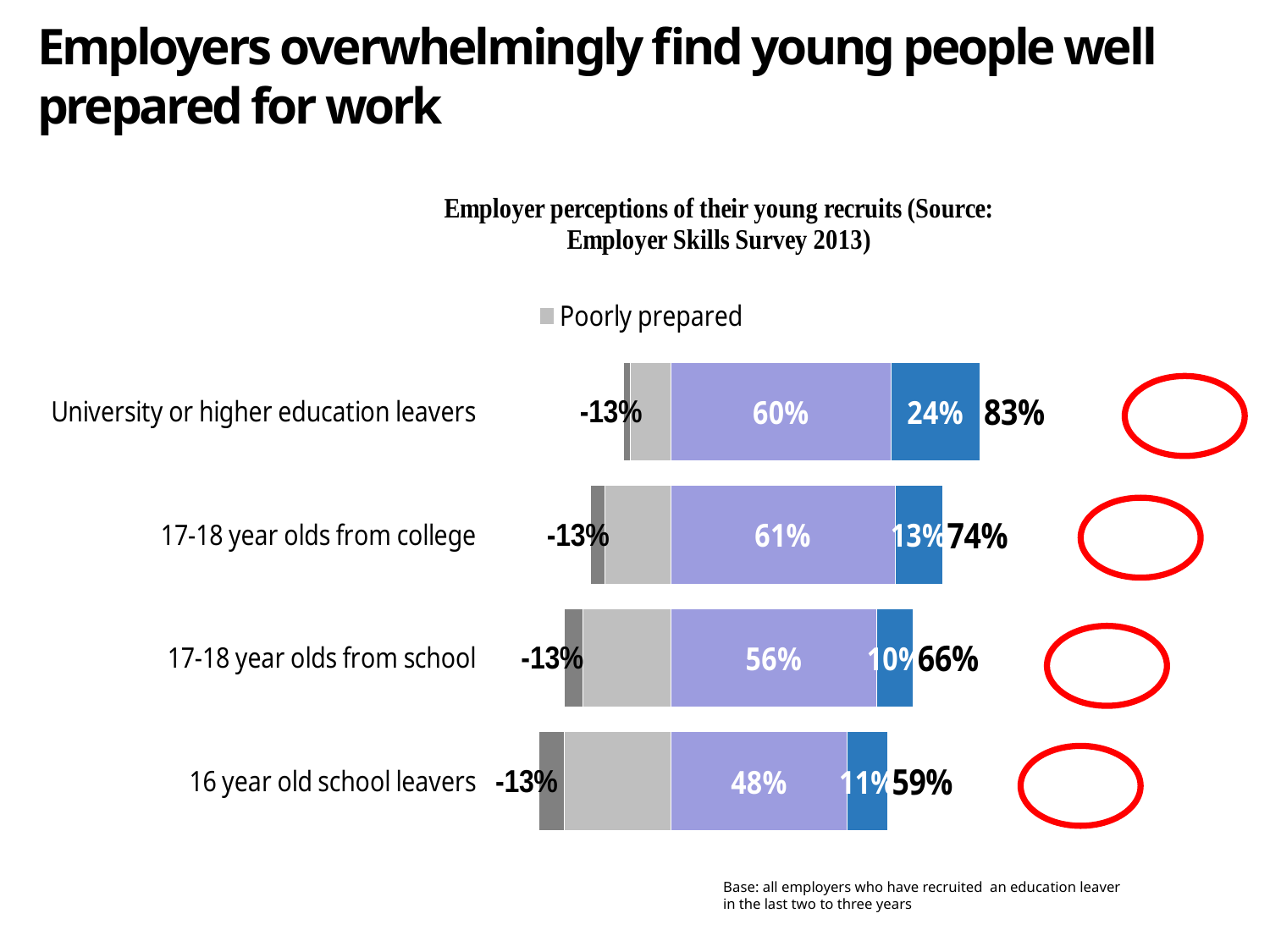
What is the difference between the purple segment values for University or higher education leavers and 16 year old school leavers? 12 percentage points Which has a larger blue segment value: University or higher education leavers or 17-18 year olds from school? University or higher education leavers How many categories are shown in the chart? 4 Which category has the highest total percentage shown at the end of its bar? University or higher education leavers What is the value of the blue segment for 17-18 year olds from college? 13% What is the title of the chart? Employer perceptions of their young recruits (Source: Employer Skills Survey 2013) What is the difference between the total percentages for University or higher education leavers (83%) and 16 year old school leavers (59%)? 24 percentage points What kind of chart is shown on the slide? Stacked bar chart What is the value of the purple segment for University or higher education leavers? 60% What is the value of the purple segment for 16 year old school leavers? 48% What total percentage is shown at the end of the bar for 17-18 year olds from school? 66% Which category has the lowest total percentage shown at the end of its bar? 16 year old school leavers